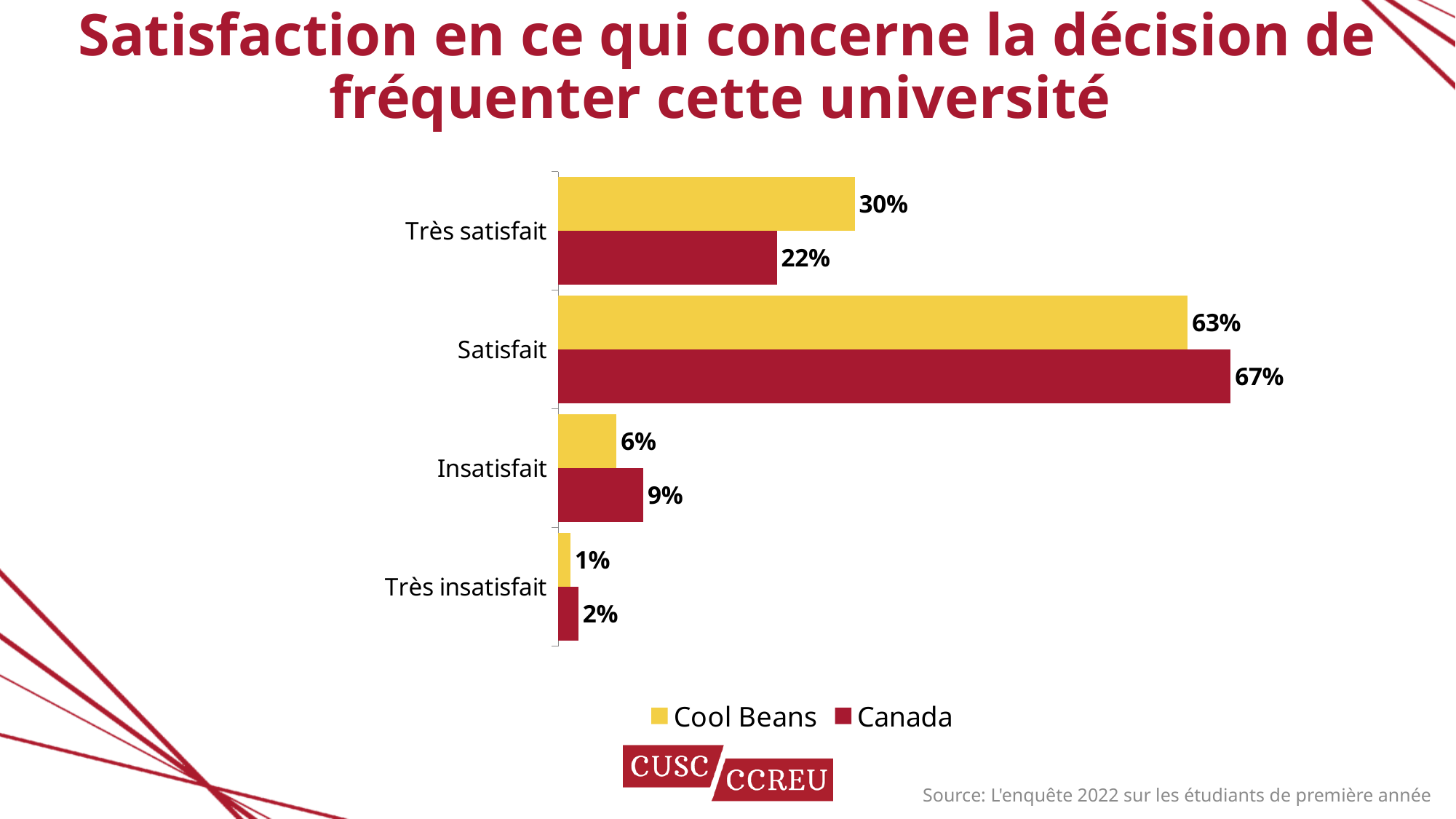
How many series does the legend list? 2 What is the difference between the Canada and Cool Beans values for Satisfait? 4% What is the Cool Beans value for Très satisfait? 30% For Insatisfait, which series has the larger value, Cool Beans or Canada? Canada What is the Cool Beans value for Très insatisfait? 1% What is the Canada value for Satisfait? 67% What kind of chart is shown on the slide? Bar chart How many categories are shown on the chart? 4 Which category has the highest Cool Beans value? Satisfait Which category has the lowest Canada value? Très insatisfait What is the Canada value for Insatisfait? 9% What is the difference between the Cool Beans and Canada values for Très satisfait? 8%